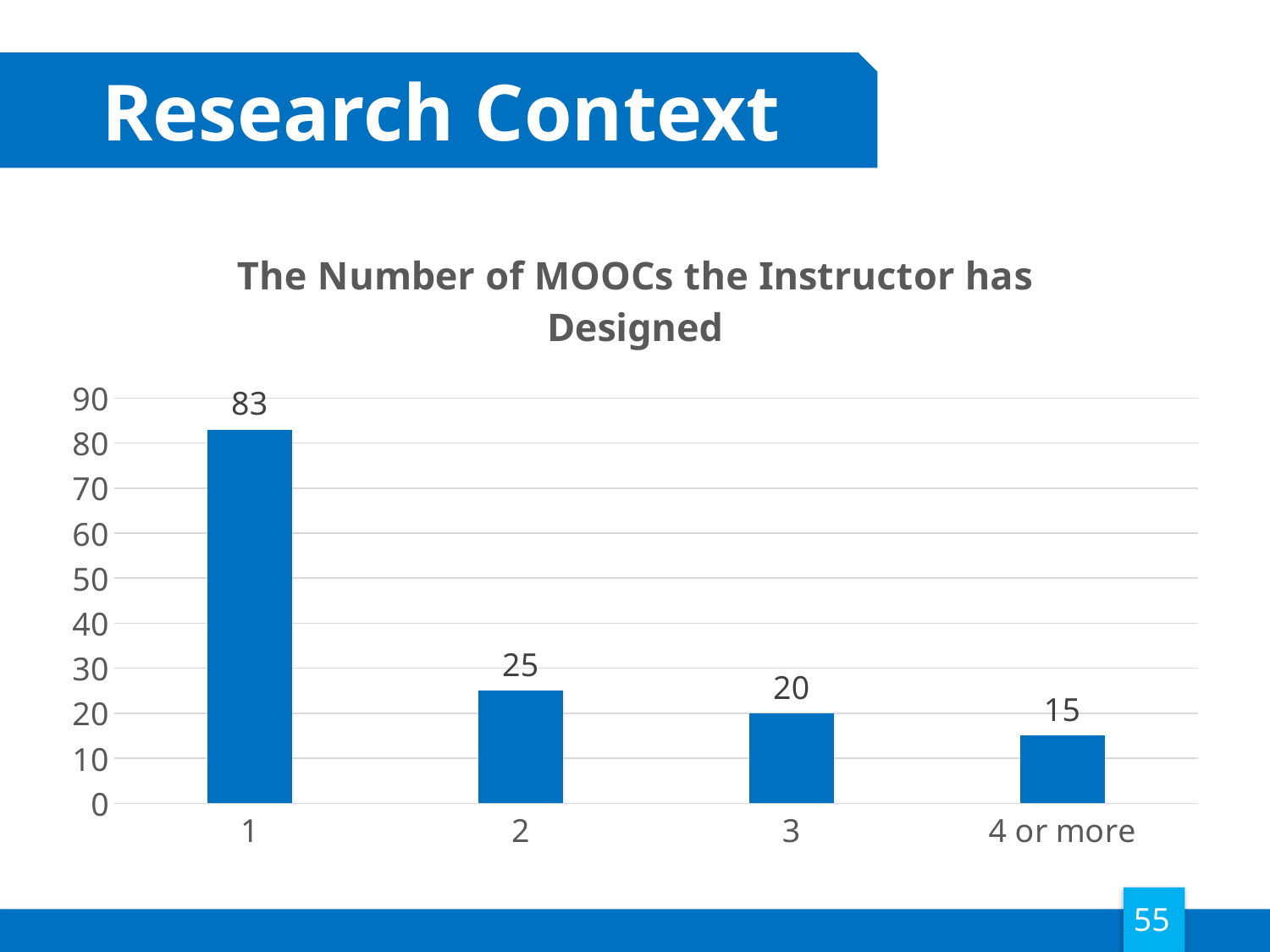
Which category has the highest value? 1 Which category has the lowest value? 4 or more What is the difference between the values for '3' and '4 or more'? 5 What is the title of the chart? The Number of MOOCs the Instructor has Designed What is the value for the category '4 or more'? 15 Do the values rise or fall from left to right along the x axis? fall How many categories are shown on the x axis? 4 What is the value for the category '1'? 83 What is the difference between the values for '1' and '2'? 58 Which is larger, the value for '2' or the value for '3'? 2 What kind of chart is shown on the slide? bar chart What is the value for the category '3'? 20